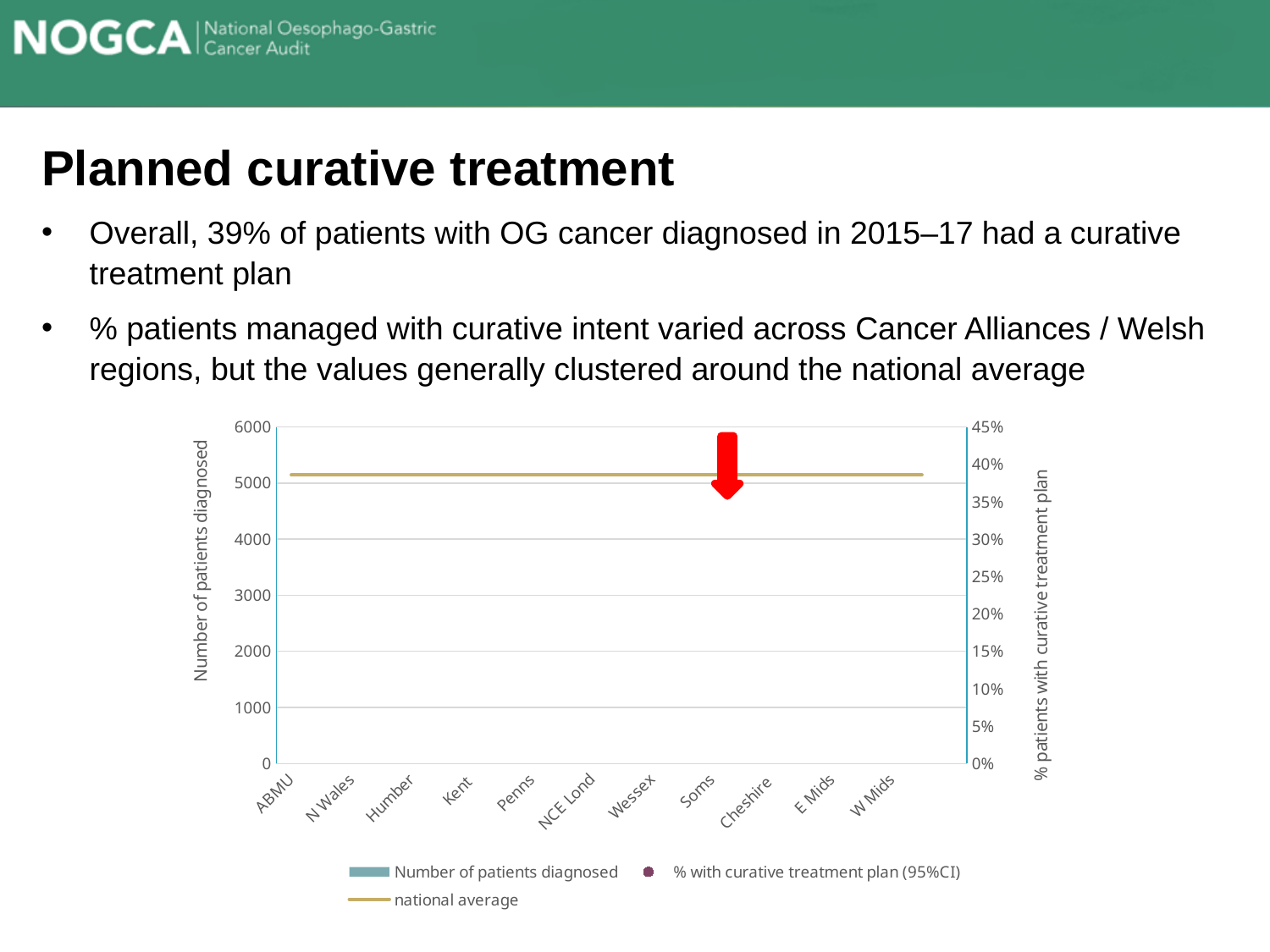
Is the national average line on the chart greater or less than 35% on the right-hand axis? greater Does the national average line rise, fall, or stay flat across the x axis of the chart? stay flat Is the national average line on the chart greater or less than 45% on the right-hand axis? less How many series does the chart's legend list? 3 What is the first category on the x axis of the chart? ABMU Is the national average line on the chart greater or less than 30% on the right-hand axis? greater